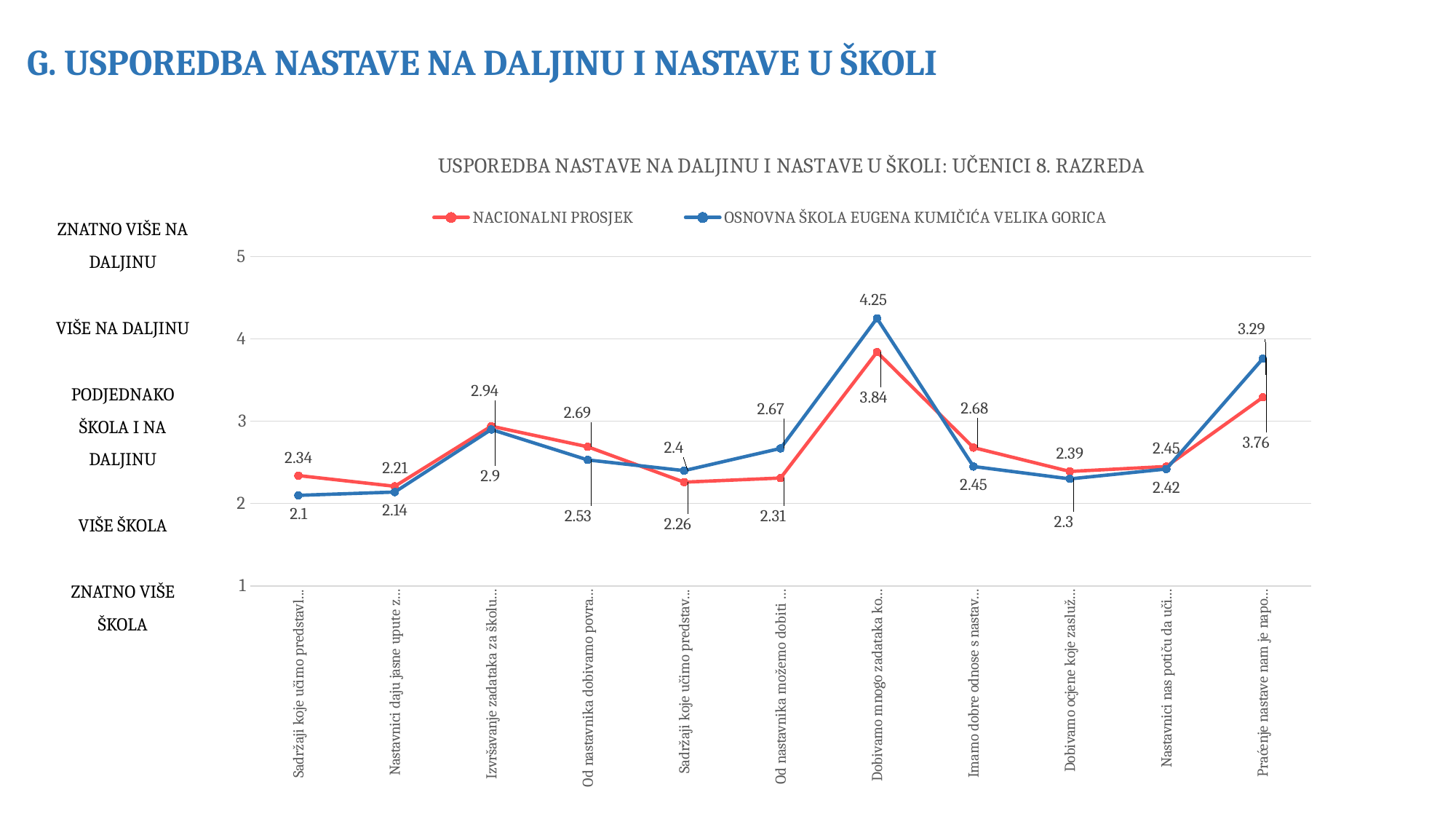
What is the lowest value plotted for OSNOVNA ŠKOLA EUGENA KUMIČIĆA VELIKA GORICA? 2.1 At the category beginning 'Dobivamo mnogo zadataka', what is the difference between the OSNOVNA ŠKOLA EUGENA KUMIČIĆA VELIKA GORICA value and the NACIONALNI PROSJEK value? 0.41 At the category beginning 'Imamo dobre odnose s nastav', which series has the higher value? NACIONALNI PROSJEK Which colour is used for the NACIONALNI PROSJEK series? Red What is the value for NACIONALNI PROSJEK at the category beginning 'Praćenje nastave nam je napo'? 3.29 At which category does the OSNOVNA ŠKOLA EUGENA KUMIČIĆA VELIKA GORICA series reach its highest value? Dobivamo mnogo zadataka ko... How many categories are plotted along the x axis? 11 How many series does the legend list? 2 At the category beginning 'Praćenje nastave nam je napo', what is the difference between the OSNOVNA ŠKOLA EUGENA KUMIČIĆA VELIKA GORICA value and the NACIONALNI PROSJEK value? 0.47 What is the value for NACIONALNI PROSJEK at the category beginning 'Od nastavnika dobivamo povra'? 2.69 What is the value for OSNOVNA ŠKOLA EUGENA KUMIČIĆA VELIKA GORICA at the category beginning 'Dobivamo mnogo zadataka'? 4.25 What type of chart is shown on the slide? Line chart